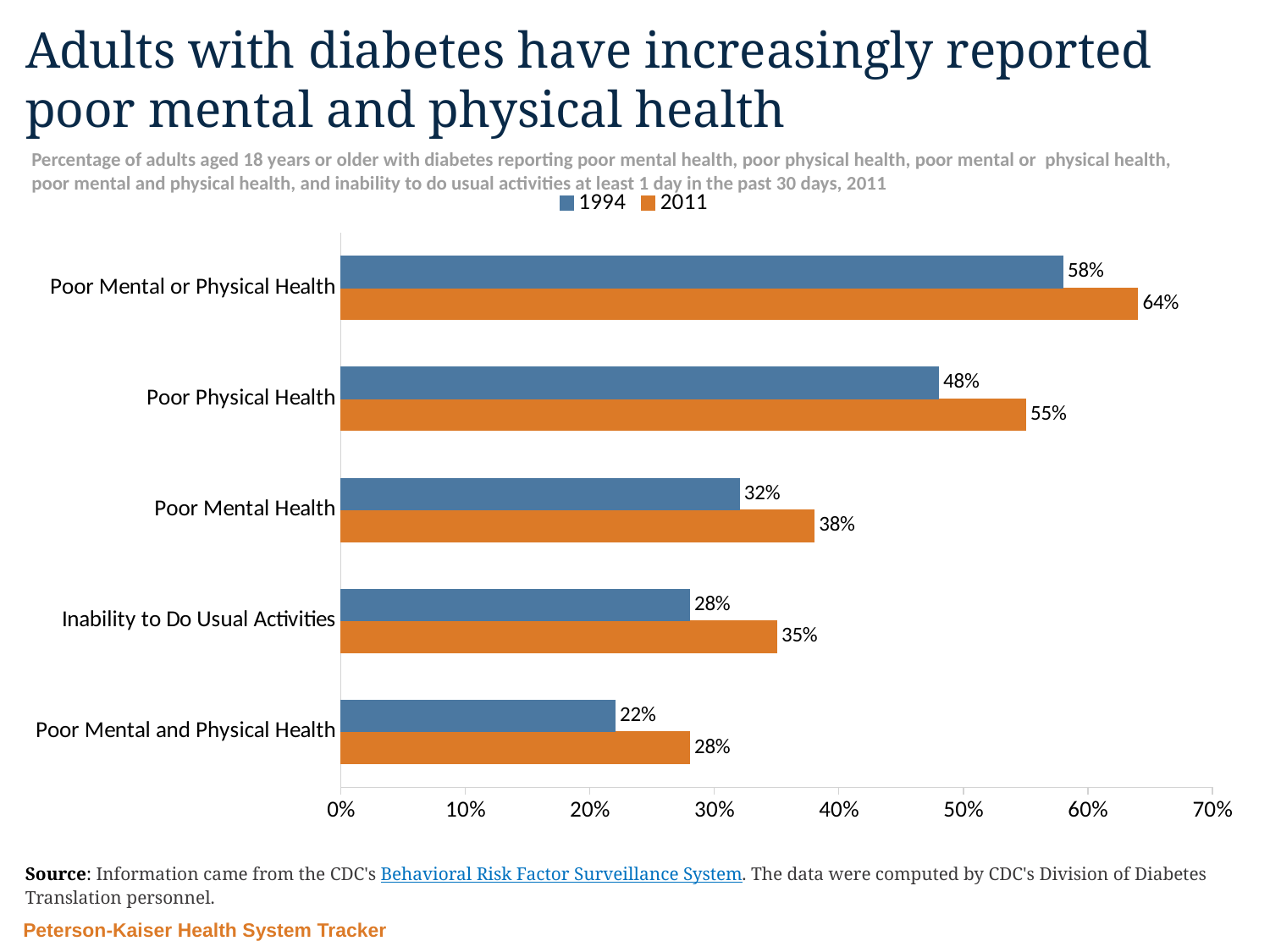
What kind of chart is shown on the slide? Bar chart Which category has the highest value for 2011? Poor Mental or Physical Health What was the value for Poor Physical Health in 1994? 48% Which is larger: the 1994 value for Poor Mental Health or the 2011 value for Poor Mental and Physical Health? 1994 value for Poor Mental Health What was the value for Inability to Do Usual Activities in 2011? 35% What percentage of adults with diabetes reported Poor Mental or Physical Health in 2011? 64% How many categories are shown on the chart? 5 How many series does the legend list? 2 Is the 2011 value for Poor Physical Health greater or less than 50%? greater What is the difference between the 2011 and 1994 values for Poor Mental Health? 6 percentage points Which category has the lowest value for 1994? Poor Mental and Physical Health What is the difference between the 2011 and 1994 values for Poor Physical Health? 7 percentage points